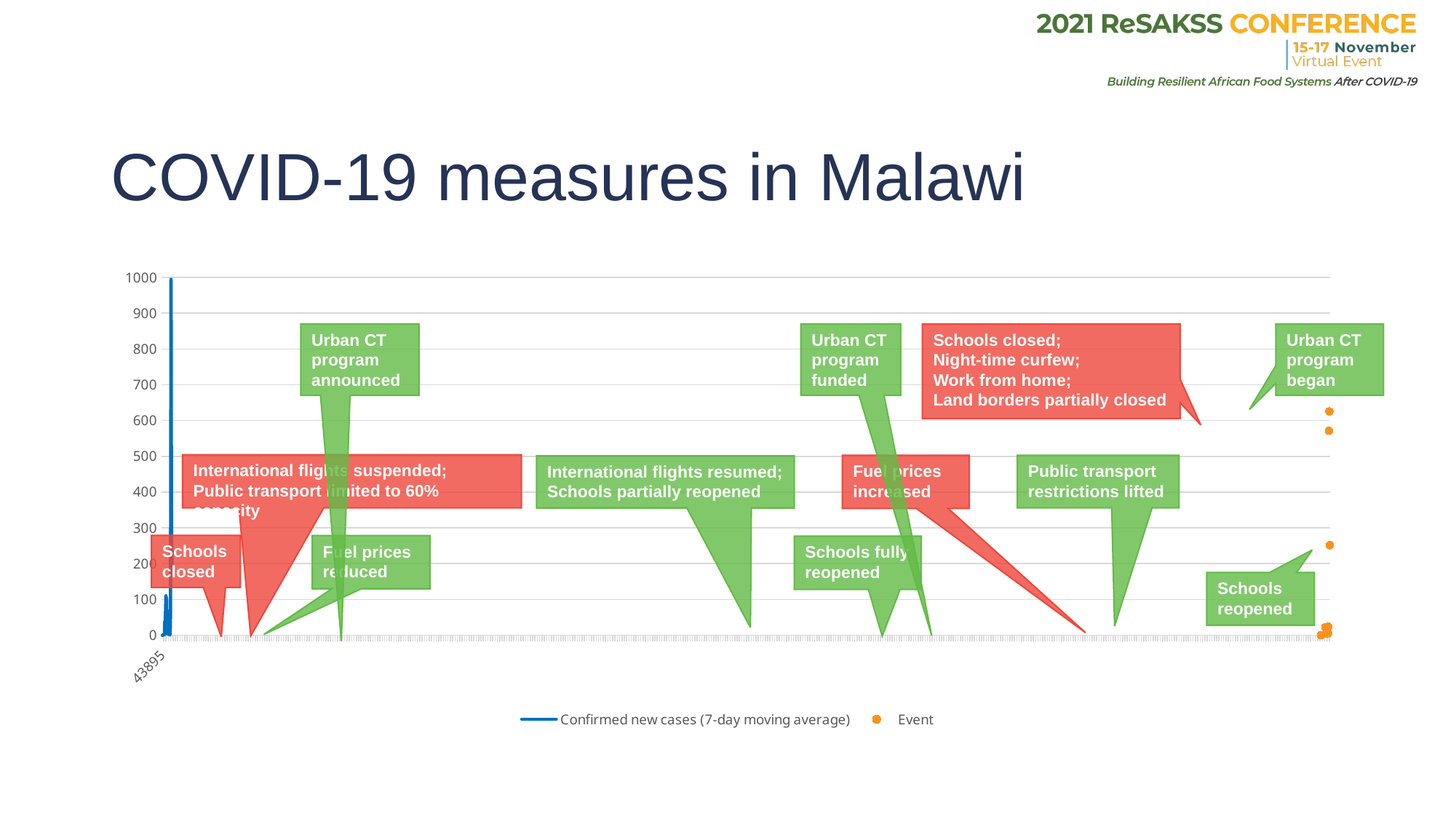
Is the peak of the blue 'Confirmed new cases' line greater or less than 500? greater What kind of chart is shown on the slide? line chart How many series does the legend list? 2 What is the highest value shown on the y axis? 1000 What is the only label printed on the x axis? 43895 Is the highest orange Event marker on the right side of the chart greater or less than 500? greater Is the orange Event marker near the 'Schools reopened' callout greater or less than 300? less What is the name of the series drawn as a blue line? Confirmed new cases (7-day moving average) What is the name of the series shown with orange markers in the legend? Event